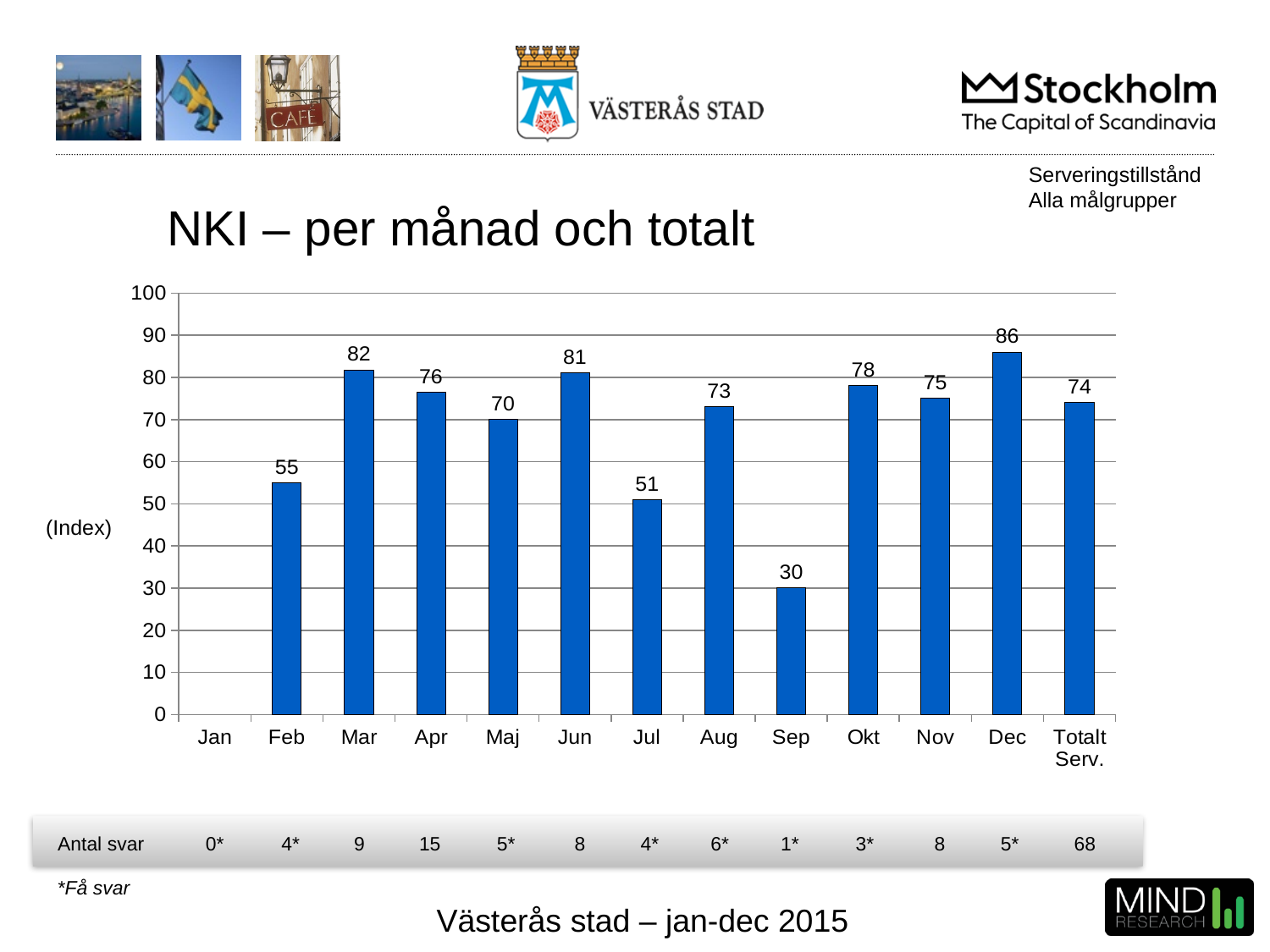
What is the NKI value for Sep? 30 What is the difference between the NKI values for Dec and Feb? 31 What kind of chart is shown on the slide? bar chart What is the NKI value for Mar? 82 How many categories are shown on the x axis? 13 Is the NKI value for Jul greater or less than 60? less What is the maximum value shown on the y axis? 100 Which is higher, the NKI value for Jun or for Aug? Jun Which month with a plotted bar has the lowest NKI value? Sep What is the title of the chart? NKI – per månad och totalt What is the value shown for Totalt Serv.? 74 Which month has the highest NKI value? Dec